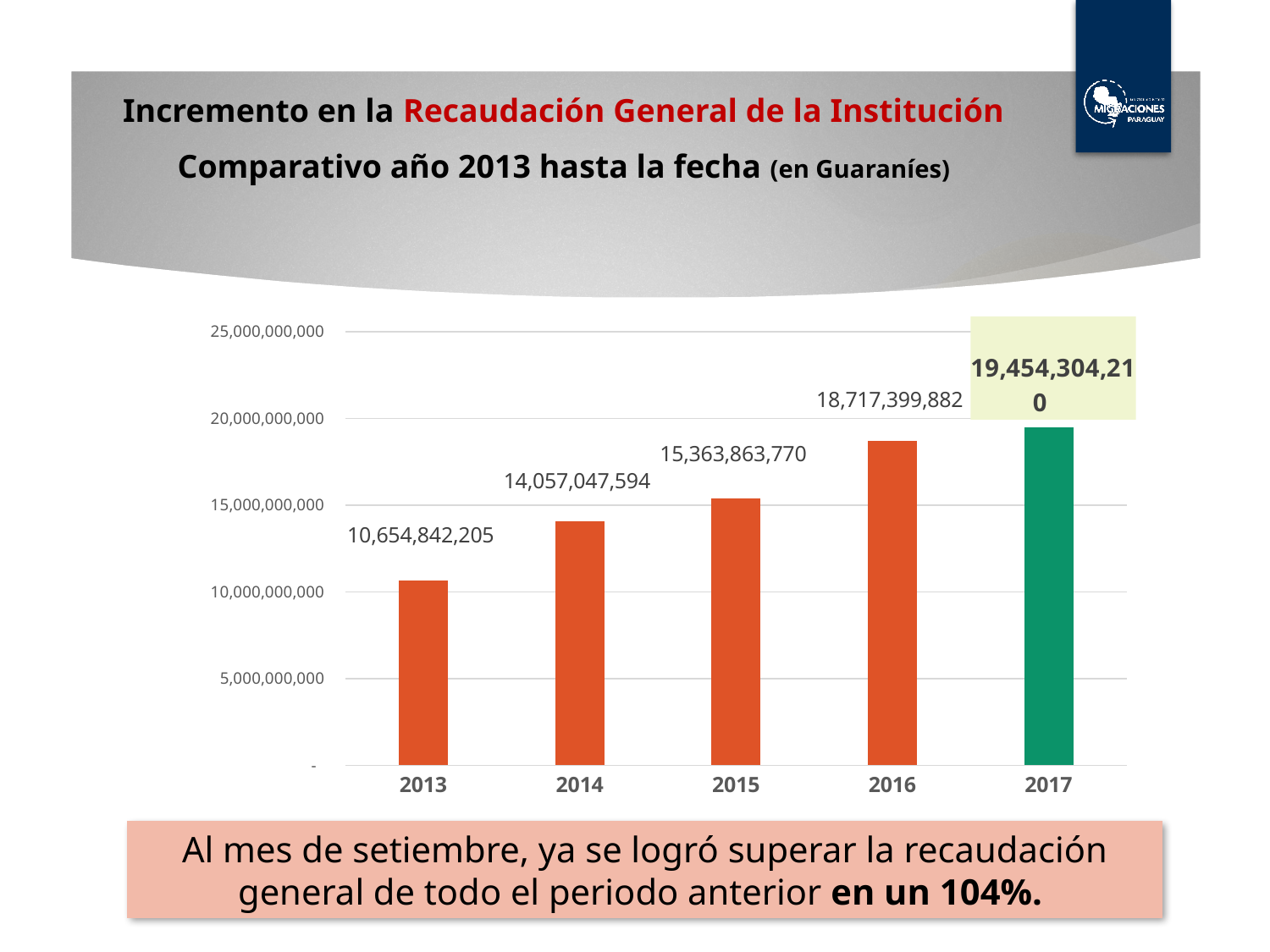
Which year has the lowest value? 2013 Do the values rise or fall from 2013 to 2017? rise Which year has the highest value? 2017 How many years are shown on the x axis? 5 What is the difference between the values for 2014 and 2013? 3,402,205,389 What kind of chart is shown on the slide? bar chart What is the value for 2013? 10,654,842,205 Is the value for 2013 greater or less than 15,000,000,000? less What is the value for 2017? 19,454,304,210 Which is larger, the value for 2014 or the value for 2016? 2016 What is the difference between the values for 2017 and 2016? 736,904,328 What is the value for 2015? 15,363,863,770